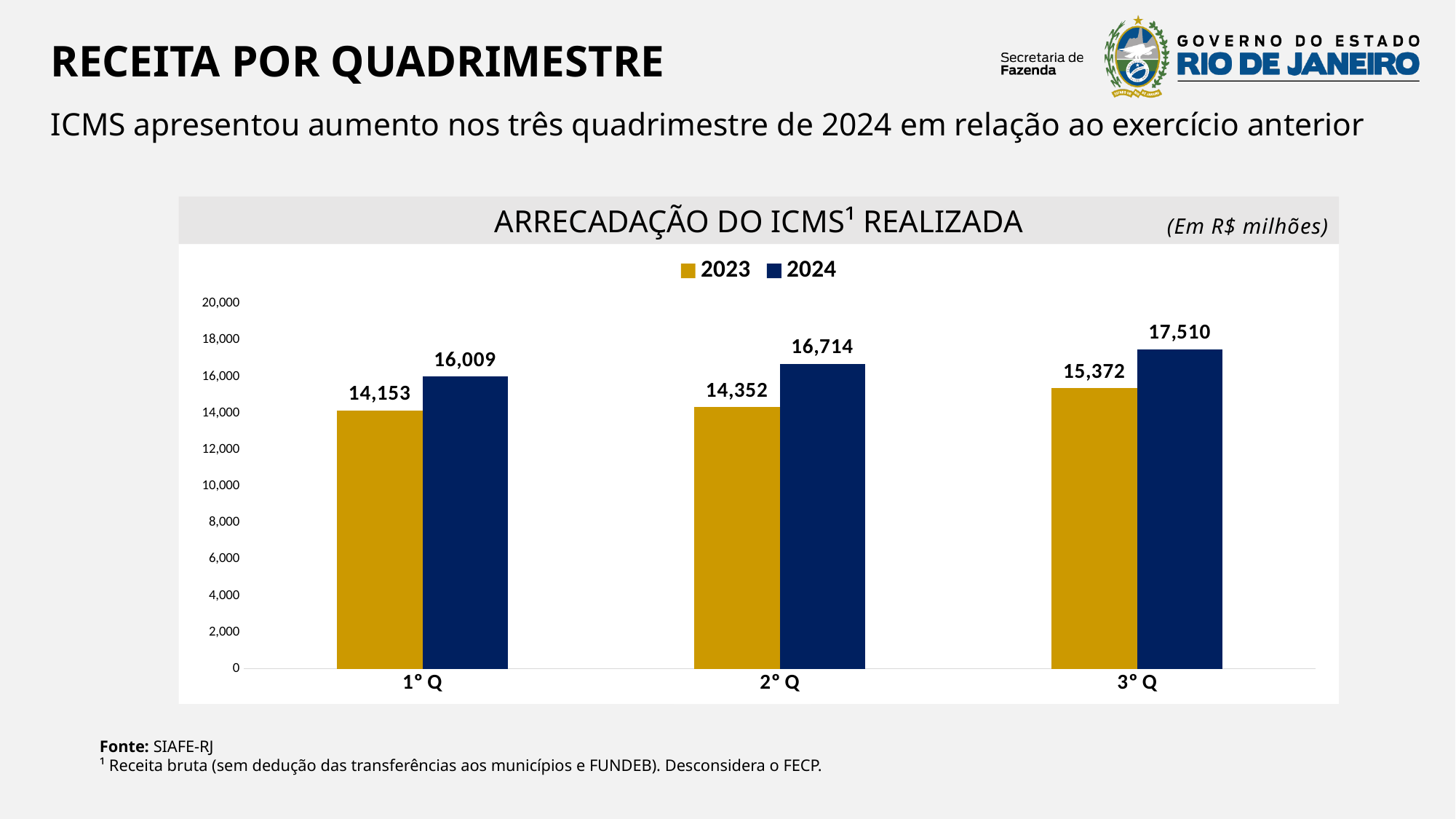
What is the 2023 value for 1° Q? 14,153 What is the 2024 value for 3° Q? 17,510 Is the 2023 value for 3° Q greater or less than 16,000? less Which is larger for 3° Q, the 2023 value or the 2024 value? 2024 Which quadrimestre has the highest 2024 value? 3° Q Which quadrimestre has the lowest 2023 value? 1° Q Do the 2024 values rise or fall from 1° Q to 3° Q? rise How many quadrimestres are shown on the x axis? 3 What is the 2024 value for 2° Q? 16,714 What is the difference between the 2024 and 2023 values for 2° Q? 2,362 What kind of chart is shown? bar chart How many series does the legend list? 2